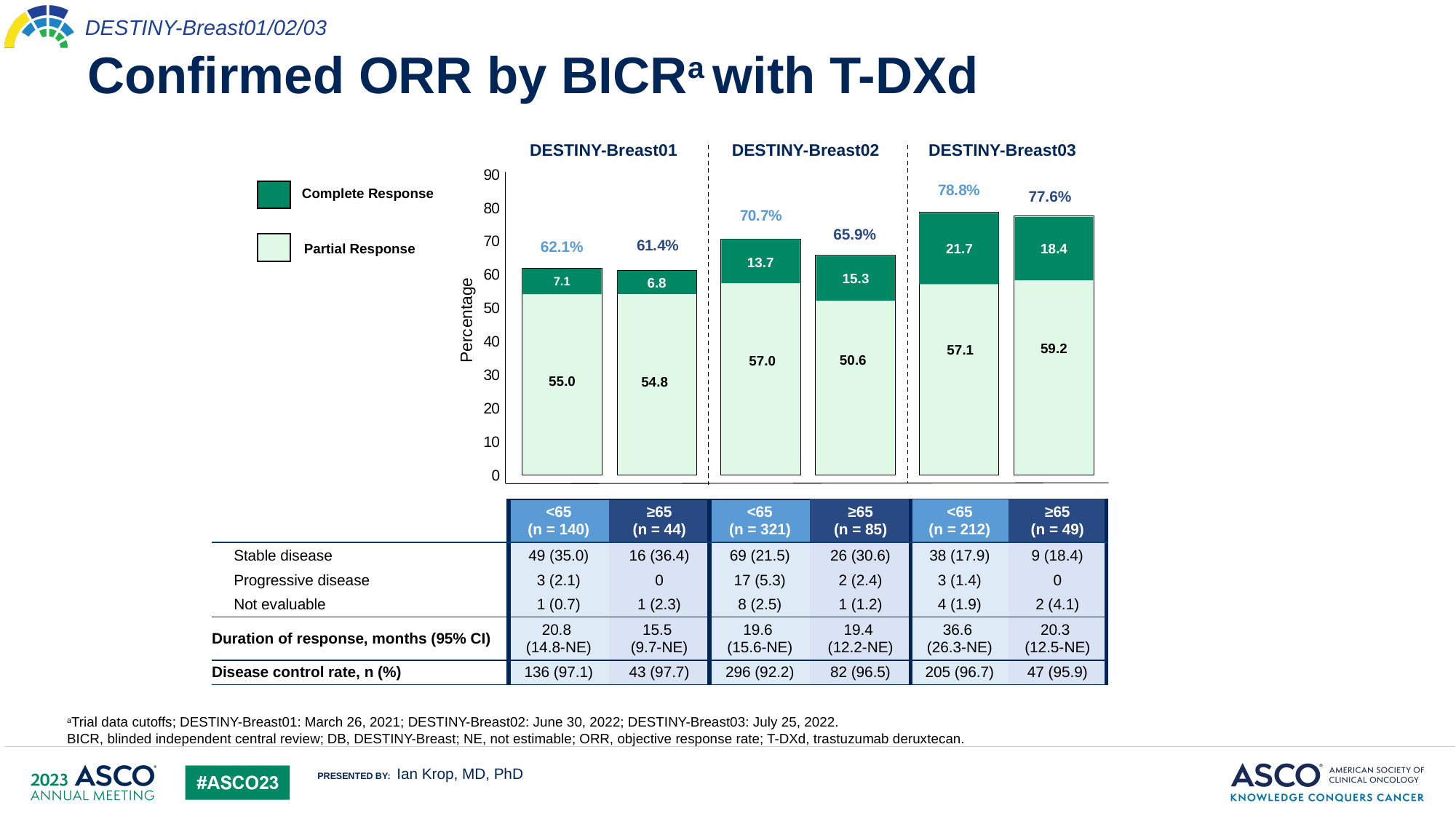
What is the Partial Response value for the ≥65 group in DESTINY-Breast02? 50.6 What is the Complete Response value for the <65 group in DESTINY-Breast03? 21.7 What is the confirmed ORR shown above the ≥65 bar in DESTINY-Breast01? 61.4% Which bar has the lowest Complete Response value? DESTINY-Breast01 ≥65 (6.8) How many series does the legend list? 2 Which bar has the highest total ORR? DESTINY-Breast03 <65 (78.8%) What kind of chart is shown on the slide? Stacked bar chart What is the difference between the ORR for the <65 and ≥65 groups in DESTINY-Breast02? 4.8 percentage points Which is larger, the Partial Response value for the <65 group or the ≥65 group in DESTINY-Breast03? ≥65 (59.2) What is the label of the y axis? Percentage Is the total ORR for the <65 group in DESTINY-Breast02 greater or less than 70? greater How many bars are plotted in the chart? 6